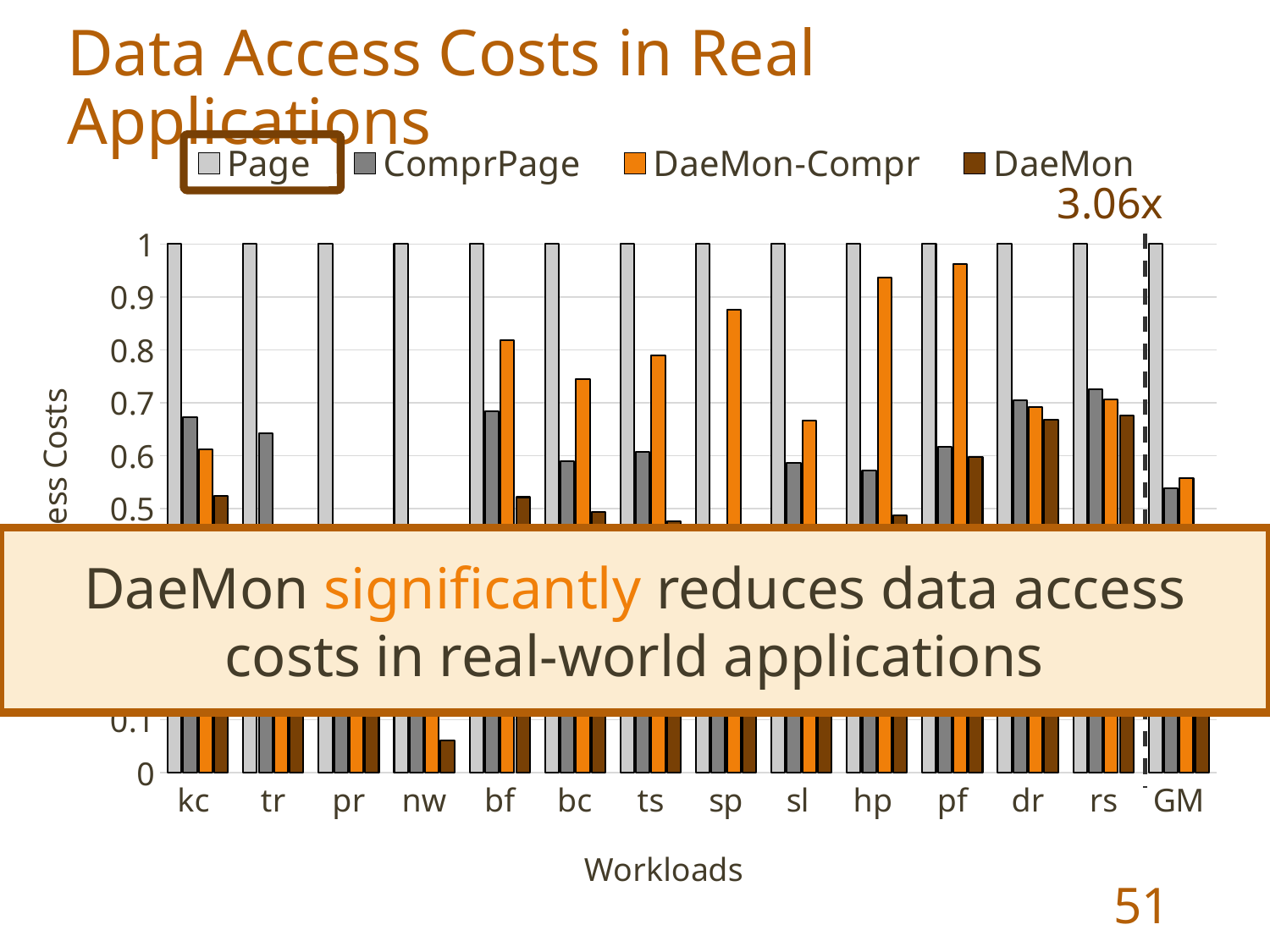
Is the DaeMon value for nw greater or less than 0.1? less What is the value of the Page series for the kc workload? 1 Is the DaeMon-Compr value for pf greater or less than 0.9? greater How many workload categories are shown on the x axis? 14 How many series does the legend list? 4 What kind of chart is shown on the slide? bar chart Is the ComprPage value for kc greater or less than 0.6? greater What is the value of the Page series for GM? 1 For the bf workload, which is larger: the ComprPage value or the DaeMon-Compr value? DaeMon-Compr For the pf workload, which is larger: the DaeMon-Compr value or the DaeMon value? DaeMon-Compr